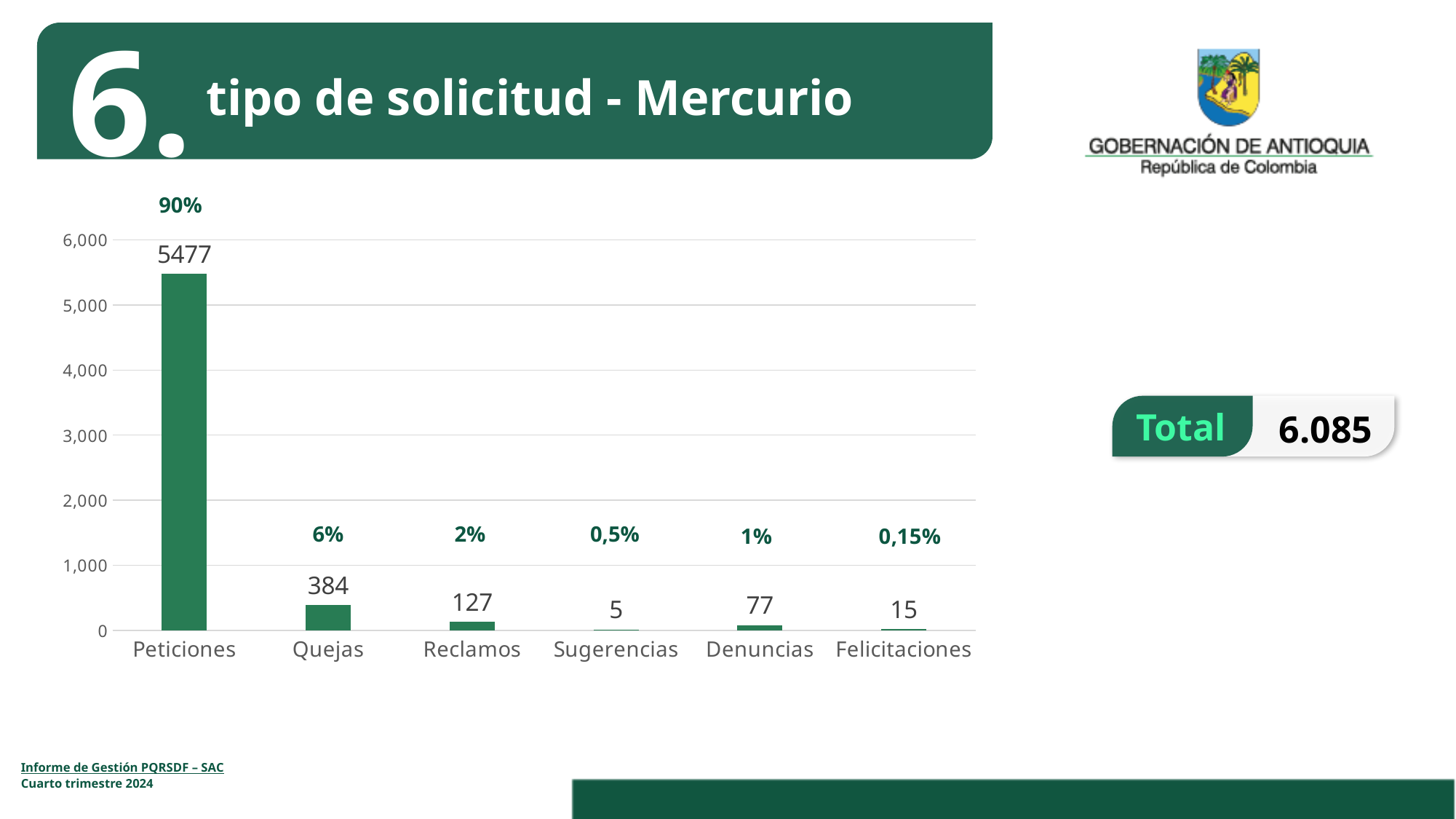
Is the value for Peticiones greater or less than 5,000? greater What is the value for Peticiones? 5477 Which category has the lowest value? Sugerencias What is the value for Denuncias? 77 What kind of chart is shown on the slide? bar chart What total is shown in the box to the right of the chart? 6.085 What is the value for Quejas? 384 Which category has the highest value? Peticiones What percentage label is shown above the Reclamos bar? 2% What is the difference between the values for Quejas and Reclamos? 257 How many categories are shown on the x axis? 6 Which is larger, the value for Denuncias or the value for Felicitaciones? Denuncias